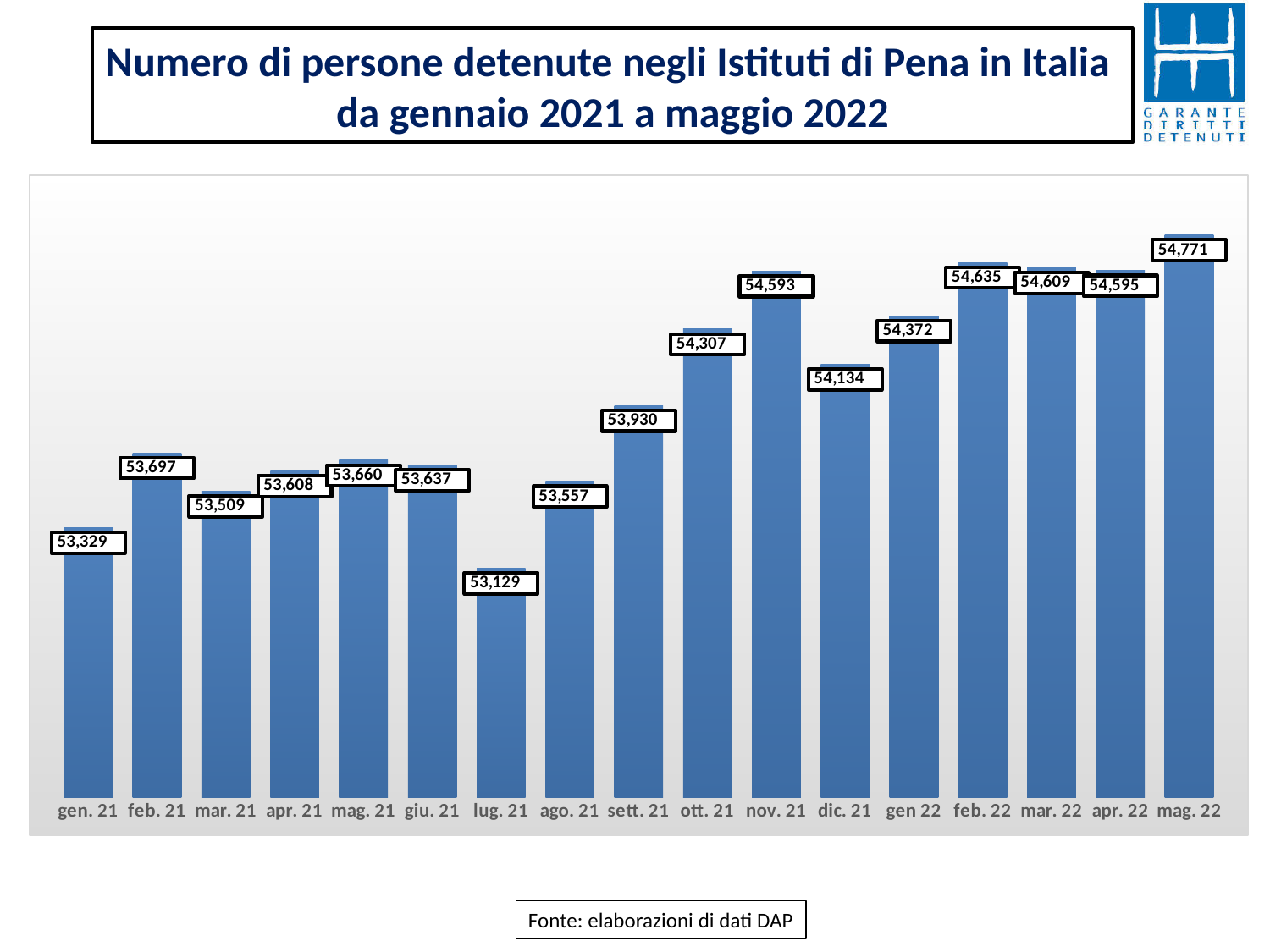
What is the value for gen. 21? 53,329 What is the value for nov. 21? 54,593 How many months are shown on the x axis? 17 Do the values generally rise or fall from gen. 21 to mag. 22? rise What is the value for mag. 22? 54,771 What is the difference between the values for nov. 21 and dic. 21? 459 What kind of chart is shown on the slide? bar chart What is the difference between the values for mag. 22 and gen. 21? 1,442 Which month has the lowest value? lug. 21 What is the value for lug. 21? 53,129 Which is larger, the value for feb. 22 or the value for mar. 22? feb. 22 Which month has the highest value? mag. 22